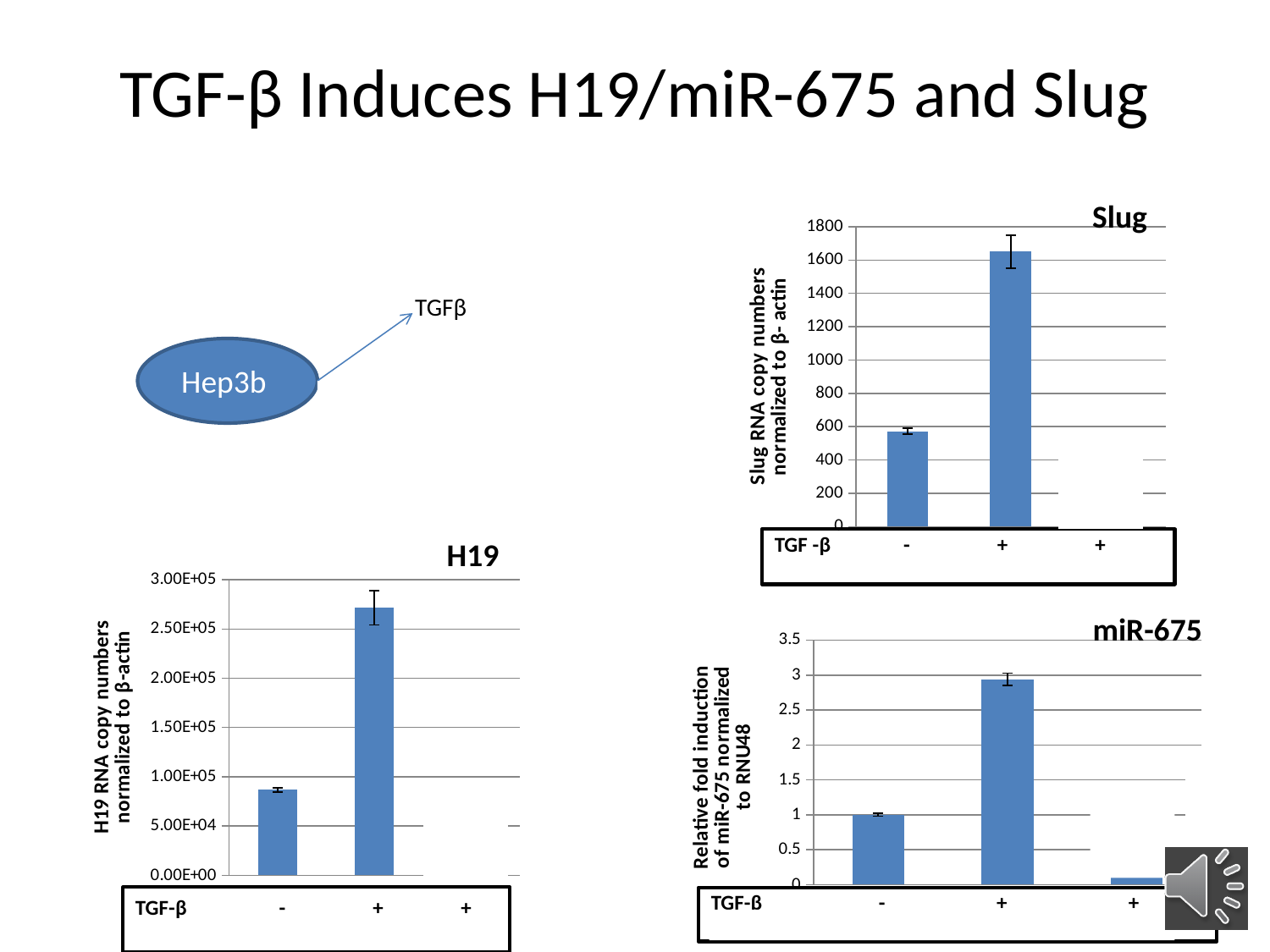
In the Slug chart, is the value for the TGF-β + condition greater or less than 1400? greater In the miR-675 chart, is the value for the second bar (TGF-β +) greater or less than 2.5? greater What kind of chart is the Slug chart? bar chart In the miR-675 chart, which bar is the highest? + (second bar) In the H19 chart, which TGF-β condition has the lower H19 RNA copy number? - In the miR-675 chart, what is the relative fold induction for the TGF-β - condition? 1 In the Slug chart, is the value for the TGF-β - condition greater or less than 400? greater What is the y-axis label of the miR-675 chart? Relative fold induction of miR-675 normalized to RNU48 In the Slug chart, which TGF-β condition has the higher Slug RNA copy number, - or +? + What is the highest value shown on the y-axis of the Slug chart? 1800